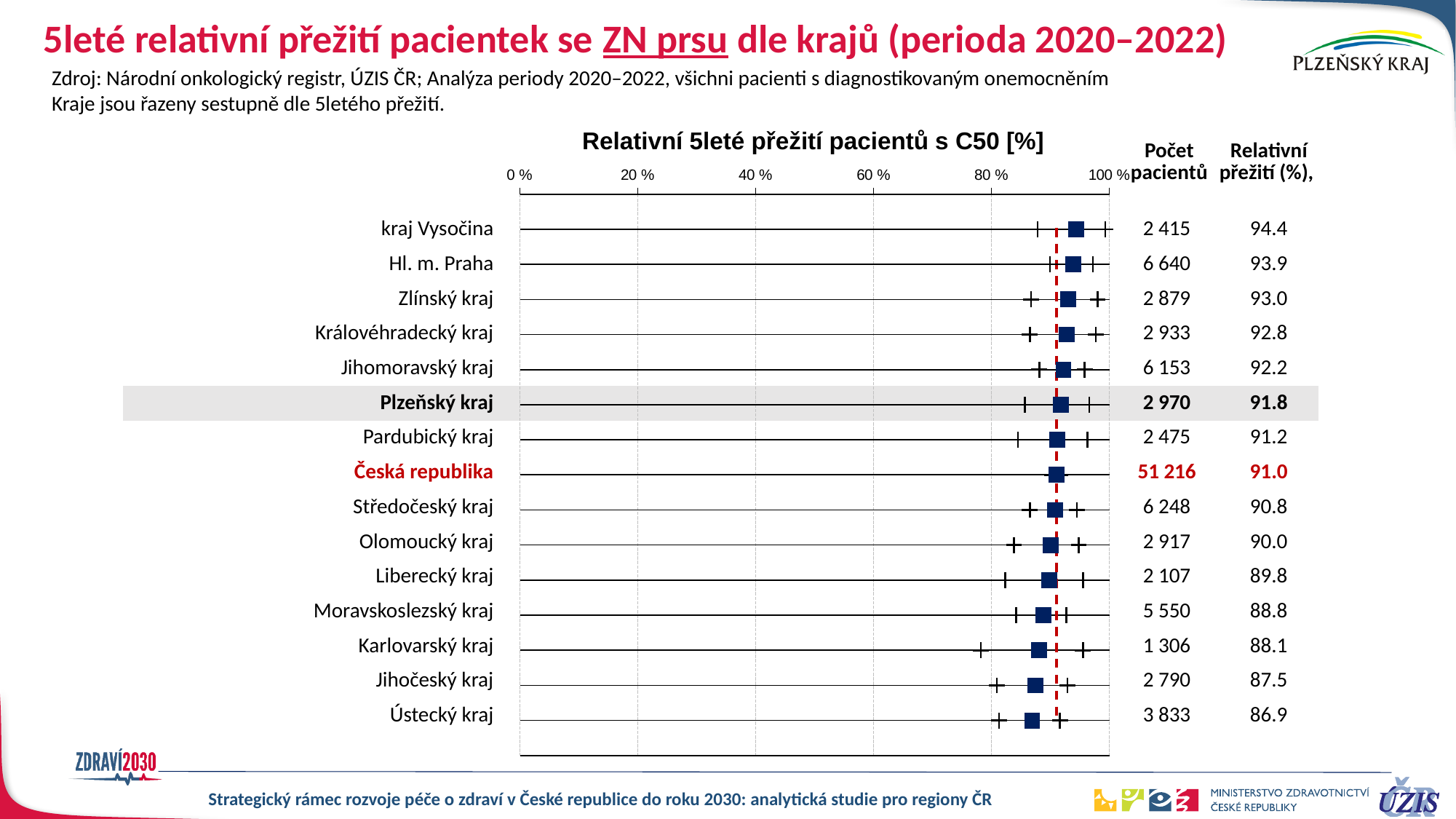
What is the title of the chart? Relativní 5leté přežití pacientů s C50 [%] What is the 5-year relative survival (%) shown for Česká republika? 91.0 Is the value for Karlovarský kraj greater or less than 80 %? greater What is the 5-year relative survival (%) for Plzeňský kraj? 91.8 Which region has the lowest 5-year relative survival? Ústecký kraj How many rows (regions including Česká republika) are plotted in the chart? 15 What is the difference in 5-year relative survival between kraj Vysočina and Ústecký kraj? 7.5 How many patients (Počet pacientů) are listed for Plzeňský kraj? 2 970 What kind of chart is shown on the slide? Dot plot with error bars (confidence intervals) Which region has the highest 5-year relative survival? kraj Vysočina Do the survival values rise or fall going from the top row to the bottom row of the chart? fall Which has a higher 5-year relative survival, Zlínský kraj or Olomoucký kraj? Zlínský kraj